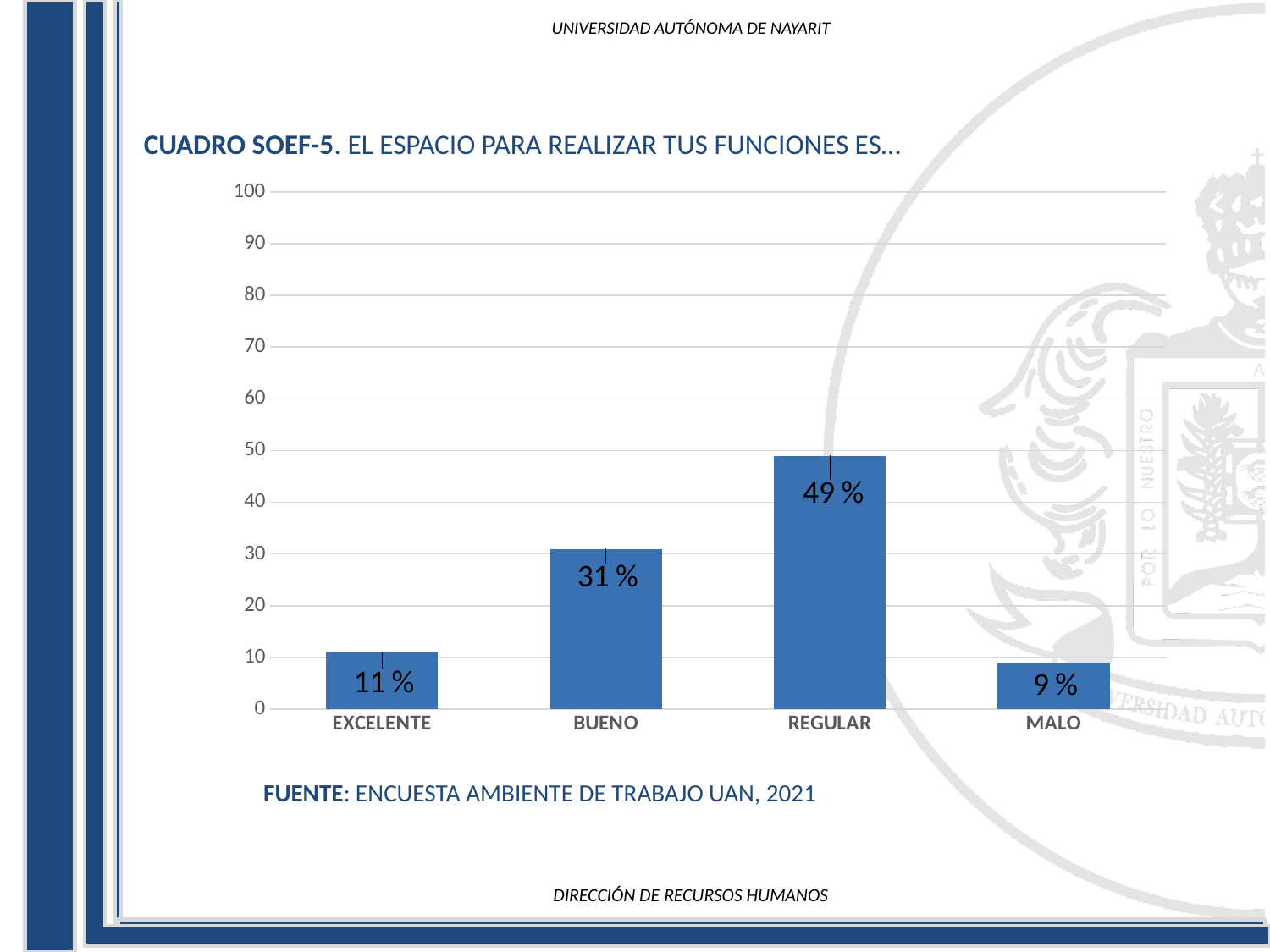
What kind of chart is shown on the slide? bar chart Which is larger, the value for EXCELENTE or the value for MALO? EXCELENTE What is the source cited below the chart? ENCUESTA AMBIENTE DE TRABAJO UAN, 2021 What is the value for BUENO? 31 % What is the value for REGULAR? 49 % Which category has the highest value? REGULAR What is the value for MALO? 9 % What is the value for EXCELENTE? 11 % Is the value for BUENO greater or less than 40? less How many categories are shown on the x axis? 4 What is the difference between the values for REGULAR and BUENO? 18 % Which category has the lowest value? MALO